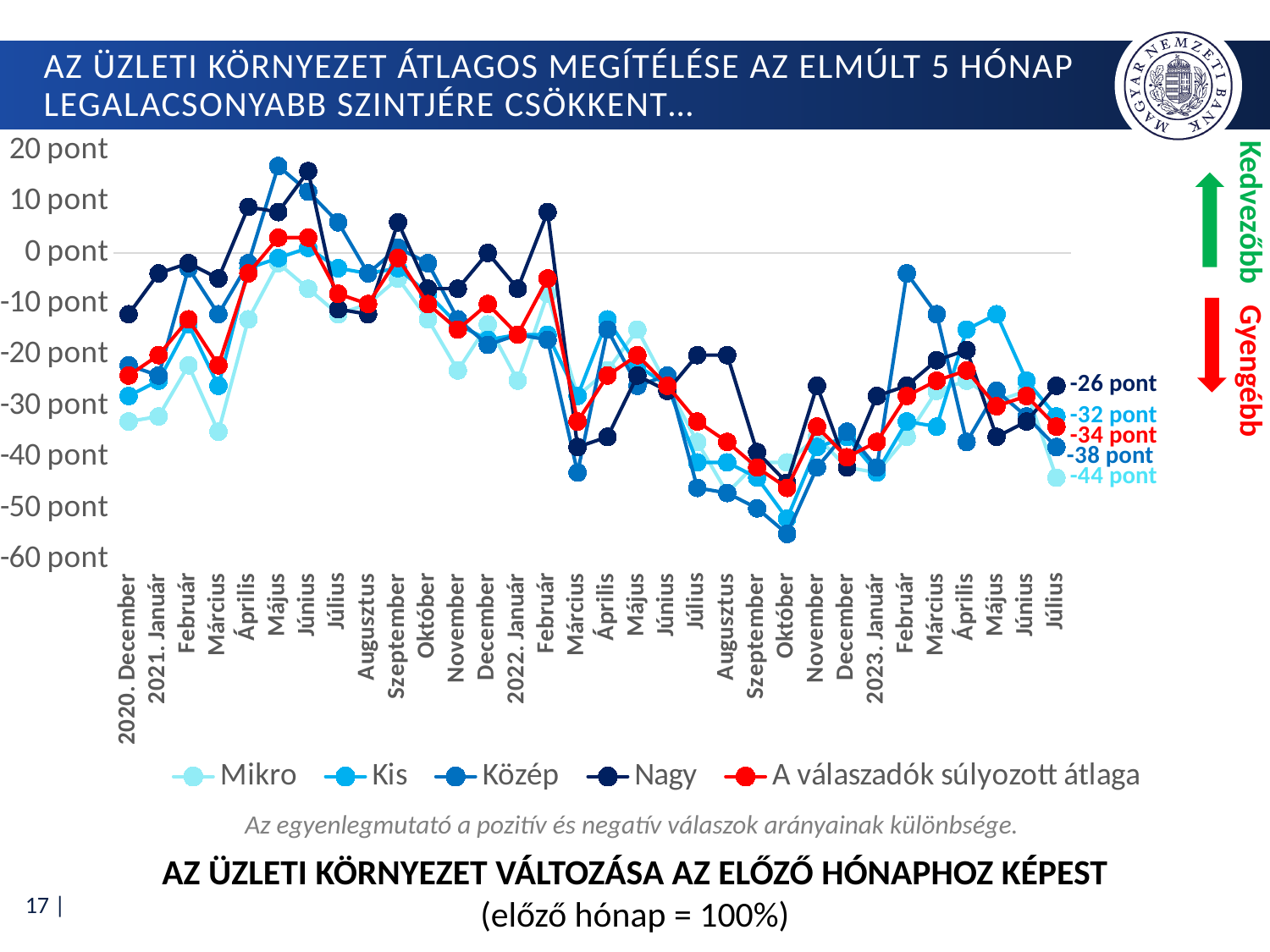
What kind of chart is shown on the slide? line chart In 2023 Július, which is larger: the value for Kis or the value for Közép? Kis What is the value for Mikro in 2023 Július? -44 pont Which series has the highest value in 2023 Július? Nagy Which series has the lowest value in 2023 Július? Mikro Is the value for Közép in 2021 Május greater or less than 10 pont? greater Is the value for Közép in 2022 Október greater or less than -50 pont? less What is the value for Nagy in 2023 Július? -26 pont What is the difference between the Nagy and Mikro values in 2023 Július? 18 pont How many series does the legend list? 5 What is the value of A válaszadók súlyozott átlaga in 2023 Július? -34 pont How many months are shown on the x axis? 32